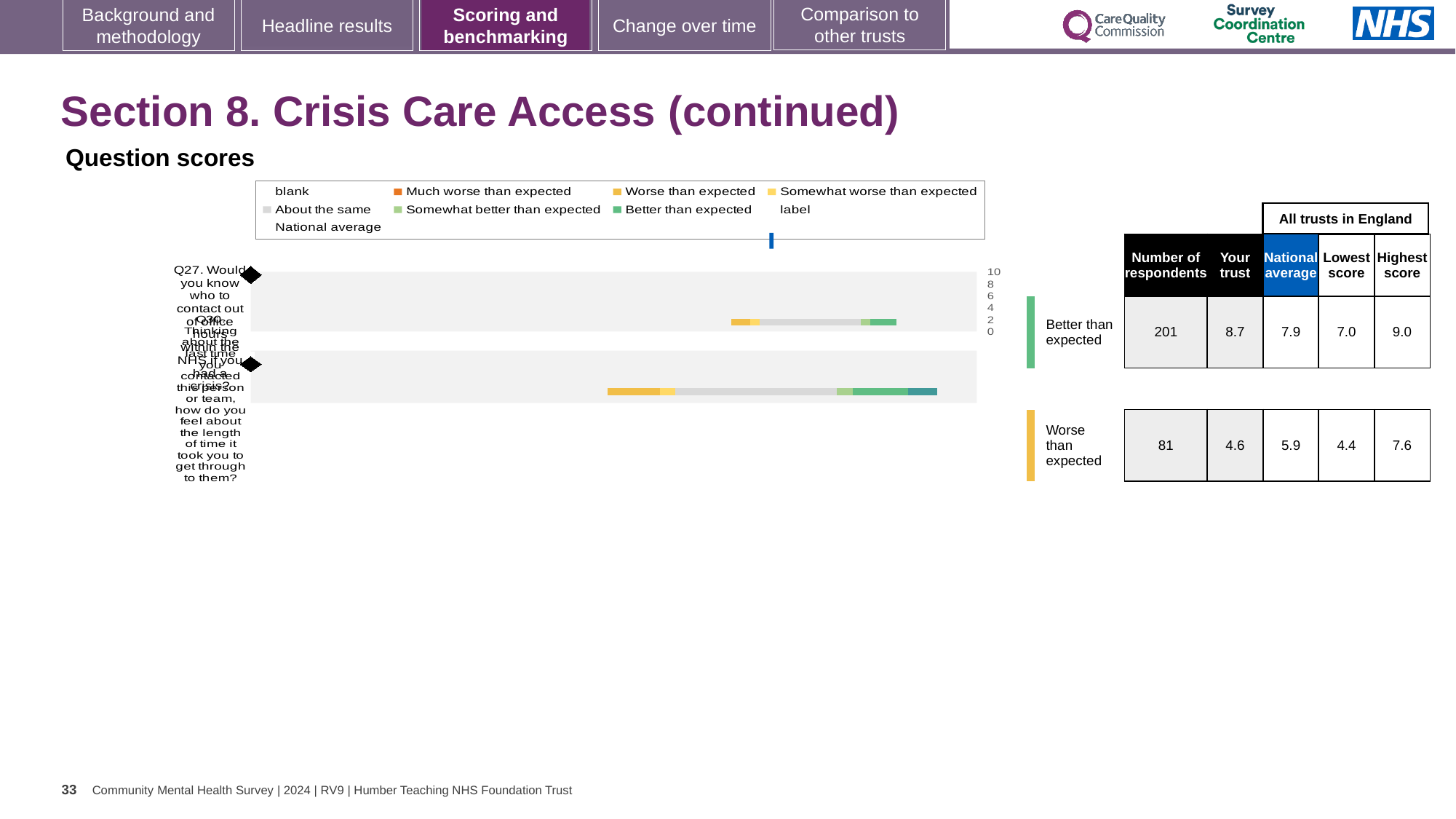
What is the 'Your trust' score for Q30? 4.6 For Q27, which is higher: the trust's score or the national average? Your trust Which question has the higher 'Your trust' score, Q27 or Q30? Q27 What is the 'Your trust' score for Q27? 8.7 What kind of chart is shown under 'Question scores'? bar chart What is the difference between the national average and the trust's score for Q30? 1.3 What is the national average score for Q27? 7.9 By how much does the trust's score for Q27 exceed the national average? 0.8 How many respondents answered Q30? 81 How many questions are plotted in the Question scores chart? 2 Which question is rated 'Worse than expected'? Q30 What is the lowest score among all trusts in England for Q30? 4.4